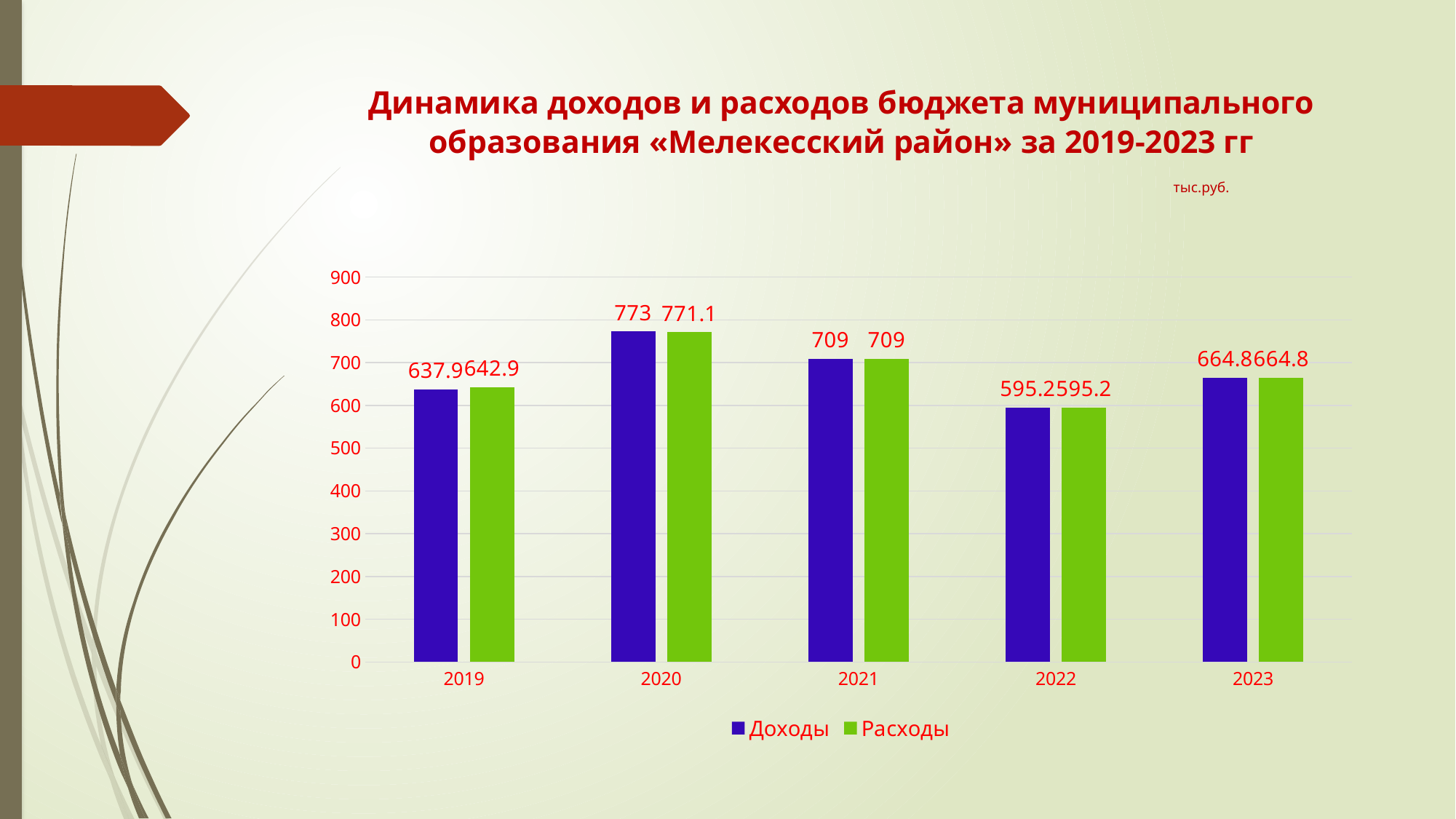
How many years are shown on the x axis? 5 What kind of chart is shown on the slide? bar chart What unit is indicated above the chart? тыс.руб. What is the difference between Доходы and Расходы in 2020? 1.9 In which year is Расходы the lowest? 2022 In which year is Доходы the highest? 2020 What is the value of Расходы for 2019? 642.9 What is the difference between Доходы in 2020 and Доходы in 2022? 177.8 What is the value of Расходы for 2023? 664.8 What is the value of Доходы for 2020? 773 How many series does the legend list? 2 Which is larger in 2019, Доходы or Расходы? Расходы